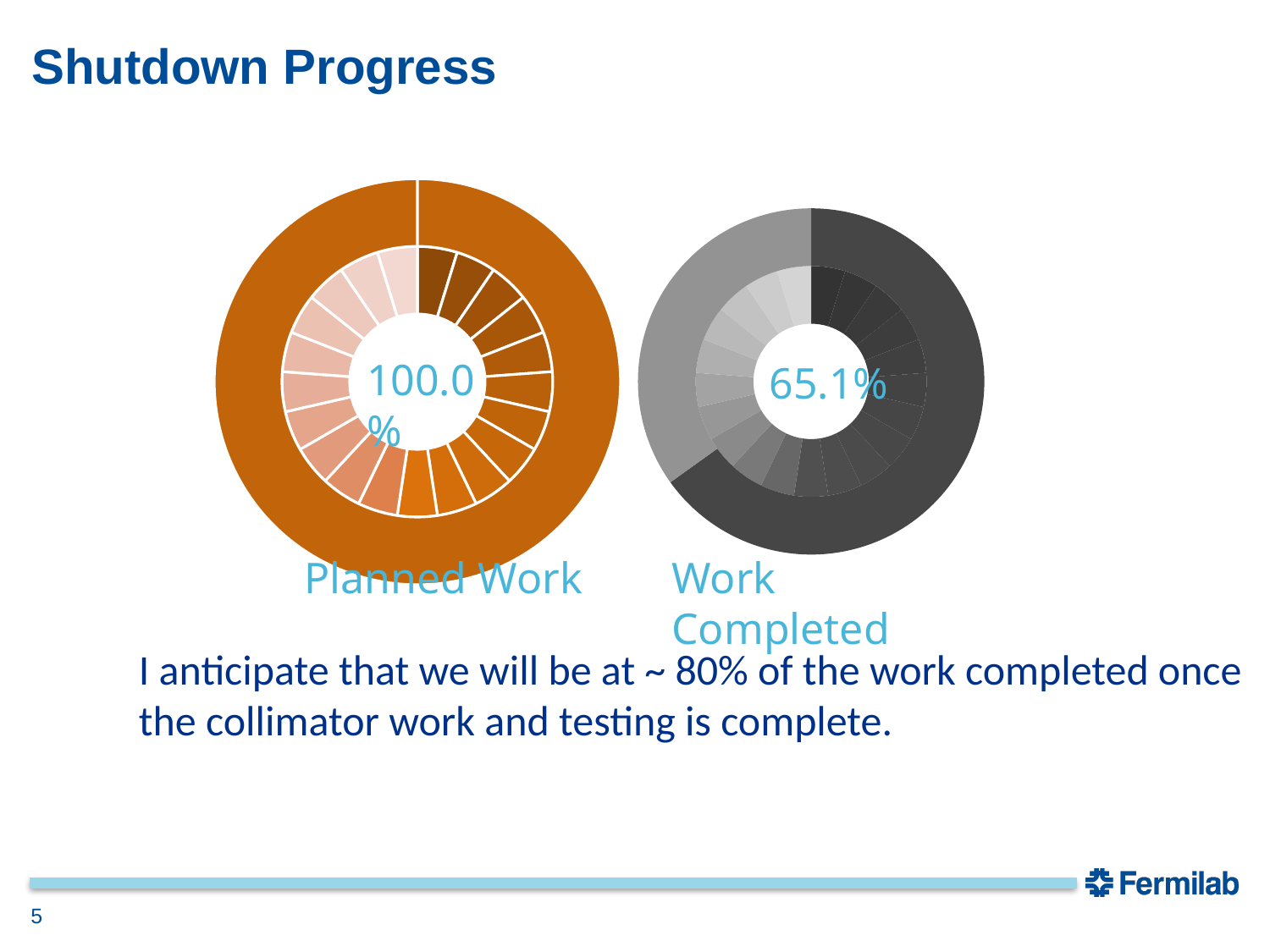
What value is shown in the centre of the Planned Work chart? 100.0% What is the difference between the Planned Work percentage and the Work Completed percentage? 34.9% What colour is the outer ring of the Planned Work chart? Orange Is the Work Completed percentage greater or less than 50%? greater What kind of chart is the Work Completed chart? Doughnut chart How many doughnut charts are shown on the slide? 2 Is the Work Completed percentage greater or less than 70%? less What value is shown in the centre of the Work Completed chart? 65.1% What kind of chart is the Planned Work chart? Doughnut chart Which chart shows the larger percentage, Planned Work or Work Completed? Planned Work What is the label under the right-hand chart? Work Completed